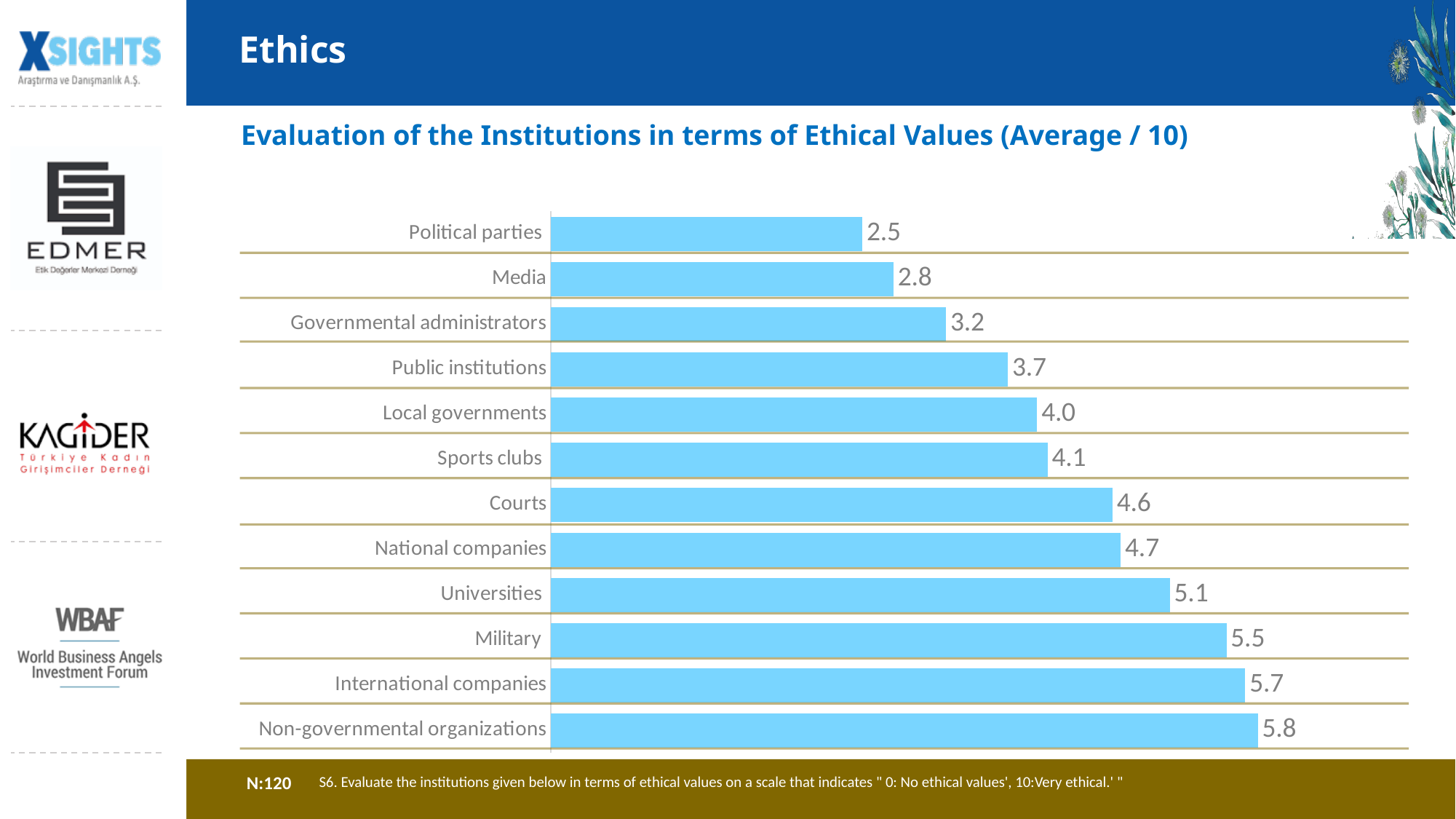
Which institution has the highest average ethical value score? Non-governmental organizations Which has a higher score, International companies or National companies? International companies What is the average ethical value score for Military? 5.5 What is the difference between the scores for Non-governmental organizations and Political parties? 3.3 Which institution has the lowest average ethical value score? Political parties What is the average ethical value score for Media? 2.8 What kind of chart is shown on the slide? Bar chart What is the difference between the scores for Universities and Public institutions? 1.4 How many institutions are shown in the chart? 12 What is the title of the chart? Evaluation of the Institutions in terms of Ethical Values (Average / 10) Which has a higher score, Governmental administrators or Local governments? Local governments What is the average ethical value score for Courts? 4.6